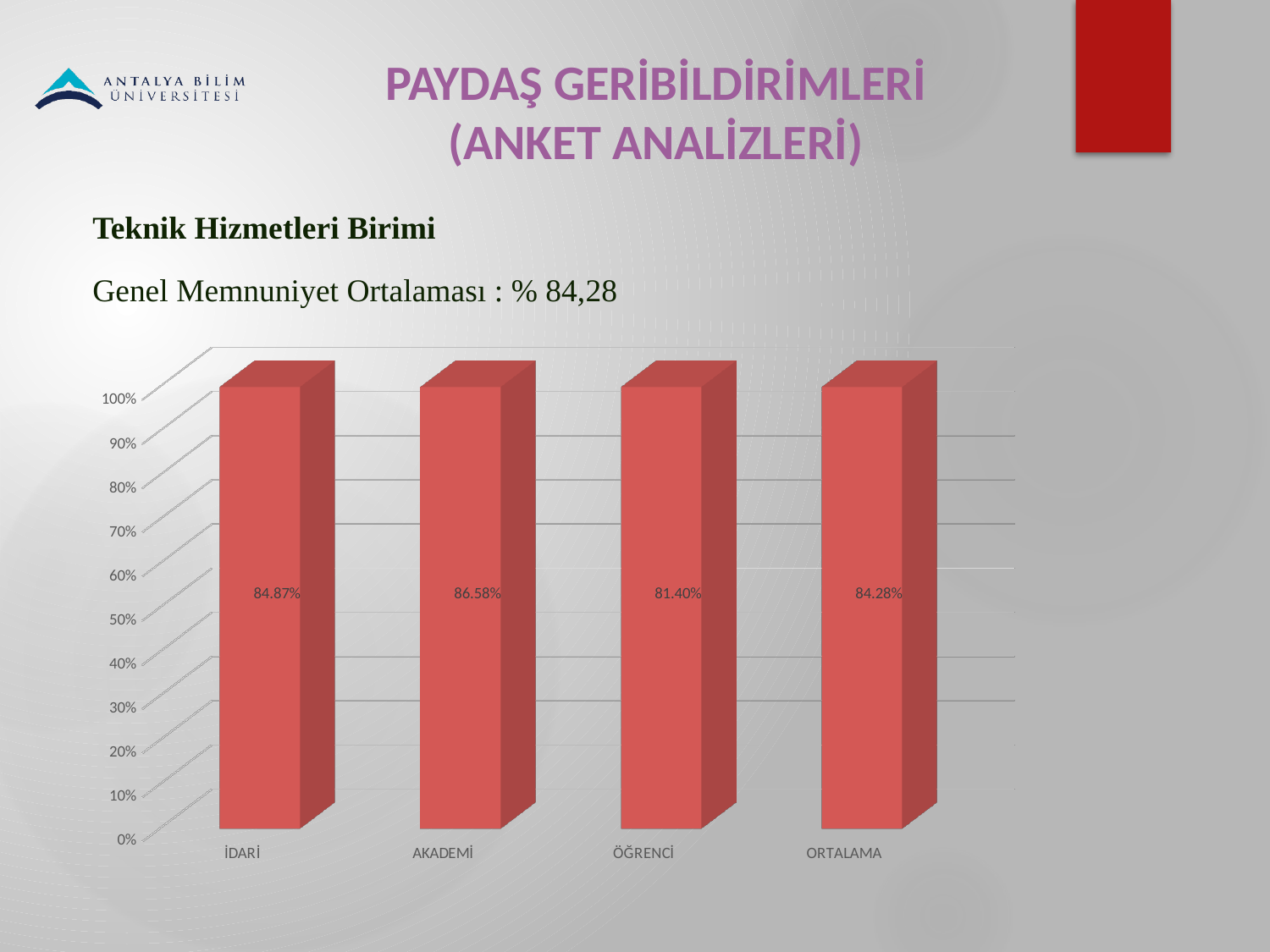
What is the difference between the values for İDARİ and ÖĞRENCİ? 3.47% What is the difference between the values for AKADEMİ and ÖĞRENCİ? 5.18% How many categories are shown on the x axis? 4 What is the value for İDARİ? 84.87% What is the value for ÖĞRENCİ? 81.40% Which is larger, the value for AKADEMİ or the value for ÖĞRENCİ? AKADEMİ Which category has the highest value? AKADEMİ What is the value for ORTALAMA? 84.28% What is the value for AKADEMİ? 86.58% What is the Genel Memnuniyet Ortalaması stated above the chart? % 84,28 What kind of chart is shown on the slide? Bar chart Which category has the lowest value? ÖĞRENCİ